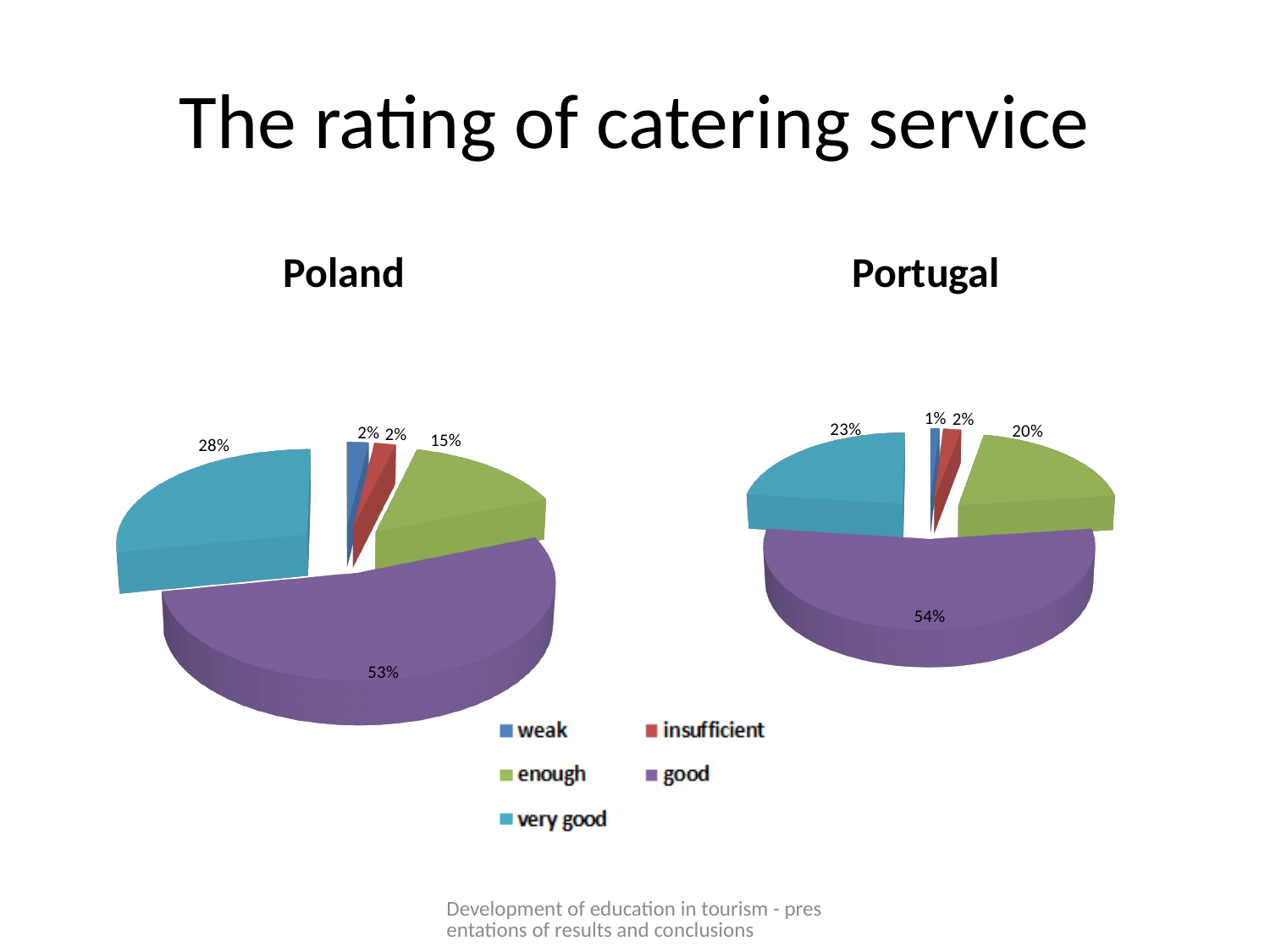
In the Poland chart, which rating has the largest share? good Is the enough share larger in the Poland chart or the Portugal chart? Portugal What is the difference between the very good share in the Poland chart and the very good share in the Portugal chart? 5 percentage points In the Poland chart, what percentage is shown for the enough rating? 15% In the Portugal chart, what percentage is shown for the weak rating? 1% In the Portugal chart, which rating has the largest share? good In the Poland chart, what share of respondents rated the catering service as good? 53% In the Portugal chart, which rating has the smallest share? weak Which colour represents the very good rating in the legend? Teal (light blue) In the Portugal chart, what share of respondents rated the catering service as very good? 23% What type of chart is used for the Poland and Portugal data? Pie chart How many rating categories does the legend list? 5